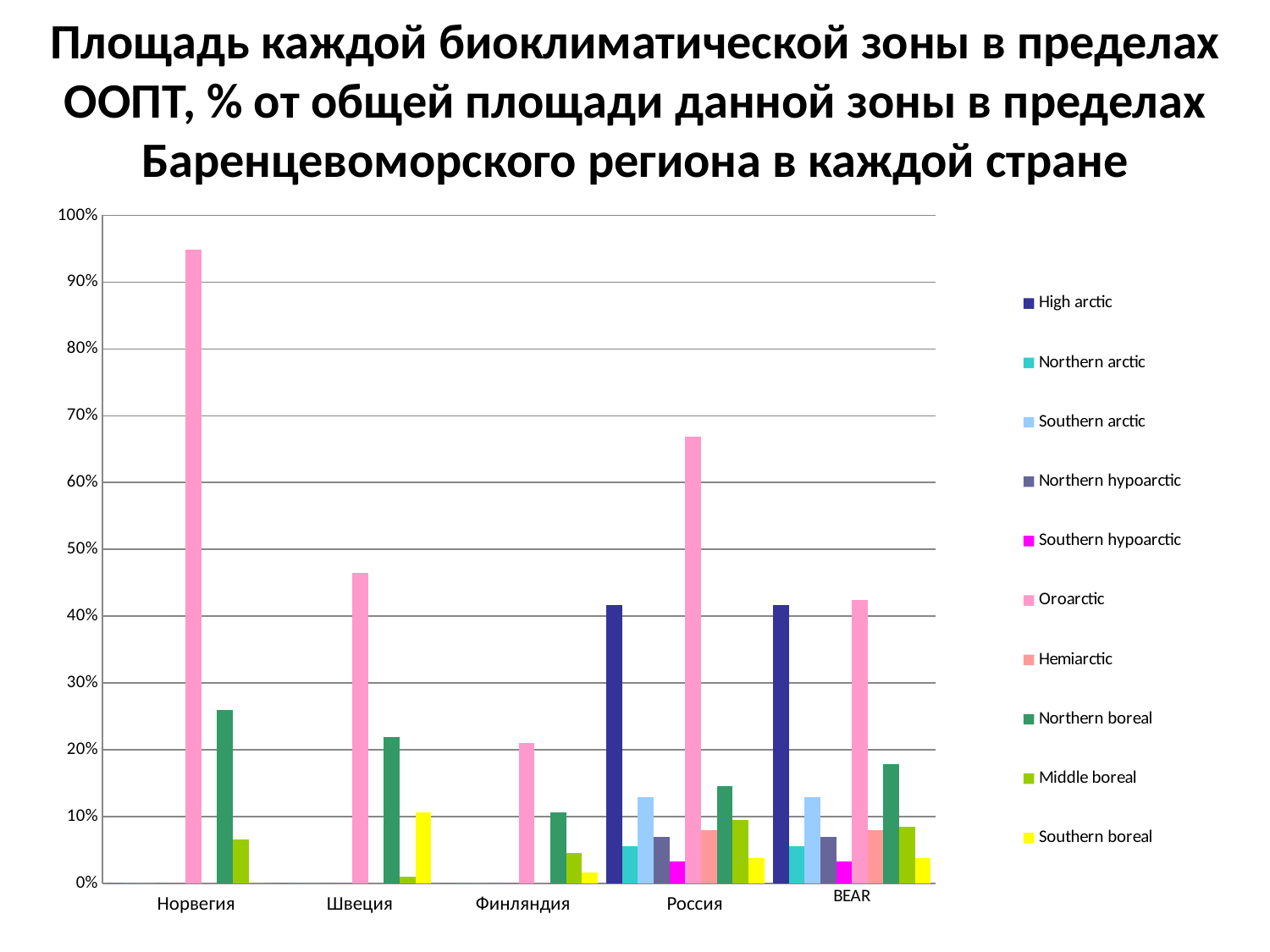
Is the Northern boreal value for Норвегия greater or less than 20%? greater Is the Oroarctic value for Норвегия greater or less than 90%? greater Which legend entry is shown in pink? Oroarctic Is the Oroarctic value for Россия greater or less than 60%? greater What kind of chart is shown on the slide? bar chart Which is larger, the Oroarctic value for Норвегия or for Швеция? Норвегия Which category has the lowest Oroarctic value? Финляндия Which category has the highest Oroarctic value? Норвегия How many series does the legend list? 10 How many countries/categories are shown along the x axis? 5